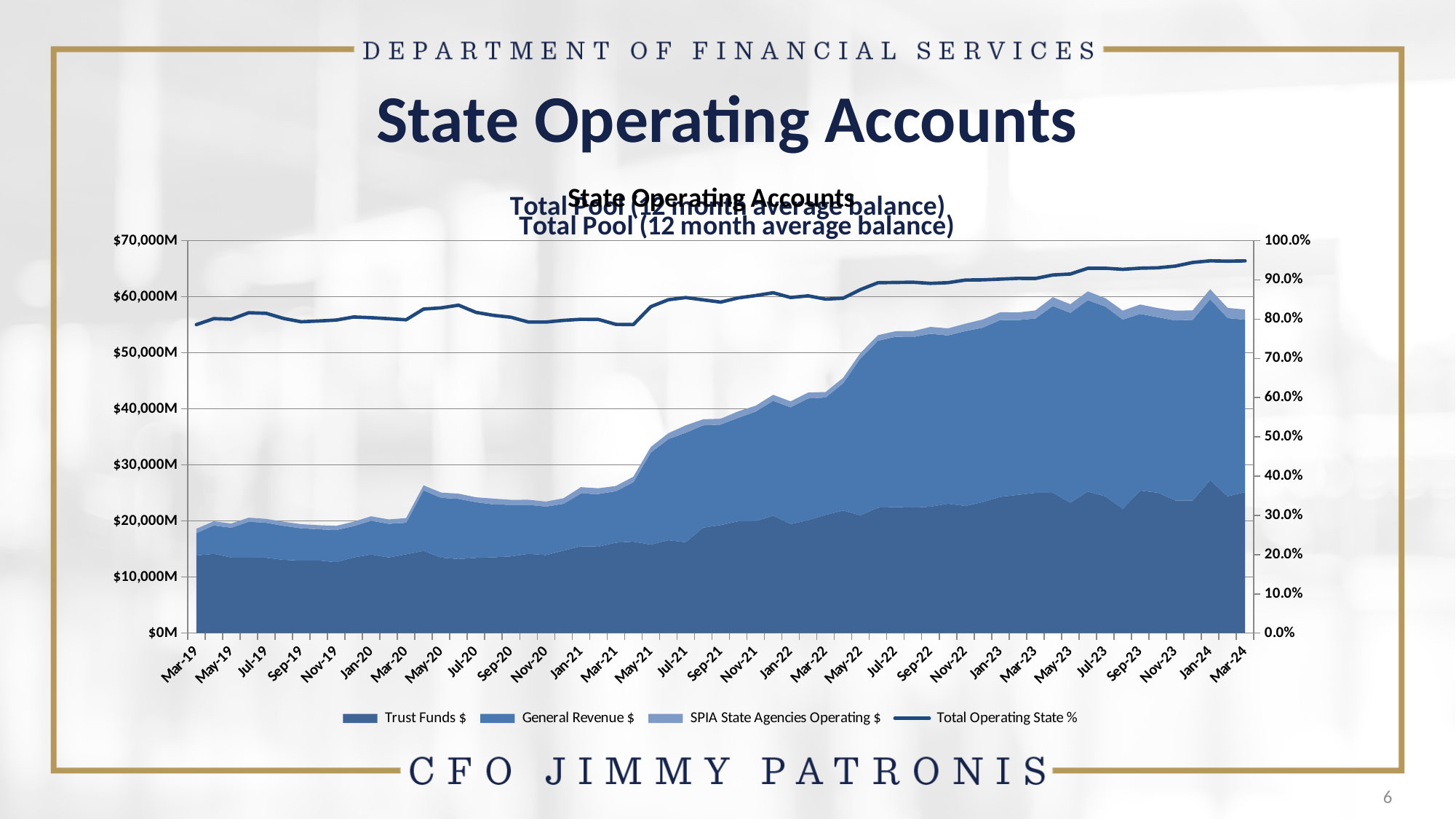
How many series does the legend list? 4 What kind of chart is shown on the slide? Stacked area chart with a line Is the Total Operating State % at Mar-24 greater or less than 90.0%? greater Which series is plotted as a line rather than an area? Total Operating State % What is the maximum value shown on the left vertical axis? $70,000M At Mar-24, which is larger: Trust Funds $ or General Revenue $? General Revenue $ Does the total stacked balance generally rise or fall from Mar-19 to Mar-24? Rise Is the Total Operating State % at Mar-19 greater or less than 80.0%? less Is the total stacked balance at Mar-24 greater or less than $50,000M? greater Is the total stacked balance larger at Mar-19 or at Mar-24? Mar-24